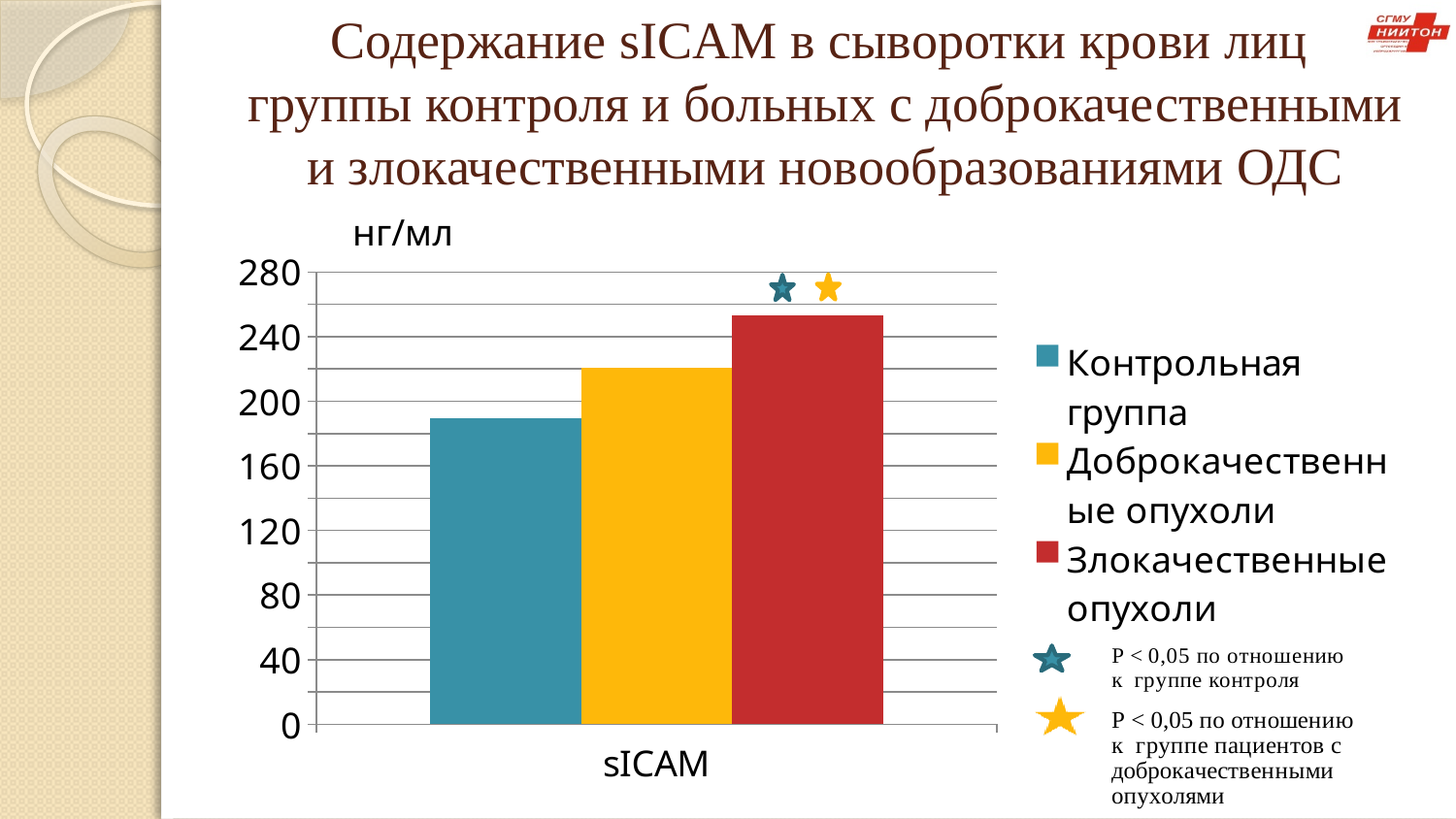
Which is larger for sICAM: Контрольная группа or Доброкачественные опухоли? Доброкачественные опухоли Is the value for Контрольная группа greater or less than 200? less Is the value for Злокачественные опухоли greater or less than 240? greater Which series has the lowest value for sICAM? Контрольная группа Which series has the highest value for sICAM? Злокачественные опухоли What kind of chart is shown on the slide? bar chart How many series does the legend list? 3 Is the value for Контрольная группа greater or less than 160? greater How many categories are shown on the x axis? 1 What colour represents Злокачественные опухоли in the chart? red What unit is shown on the y axis of the chart? нг/мл